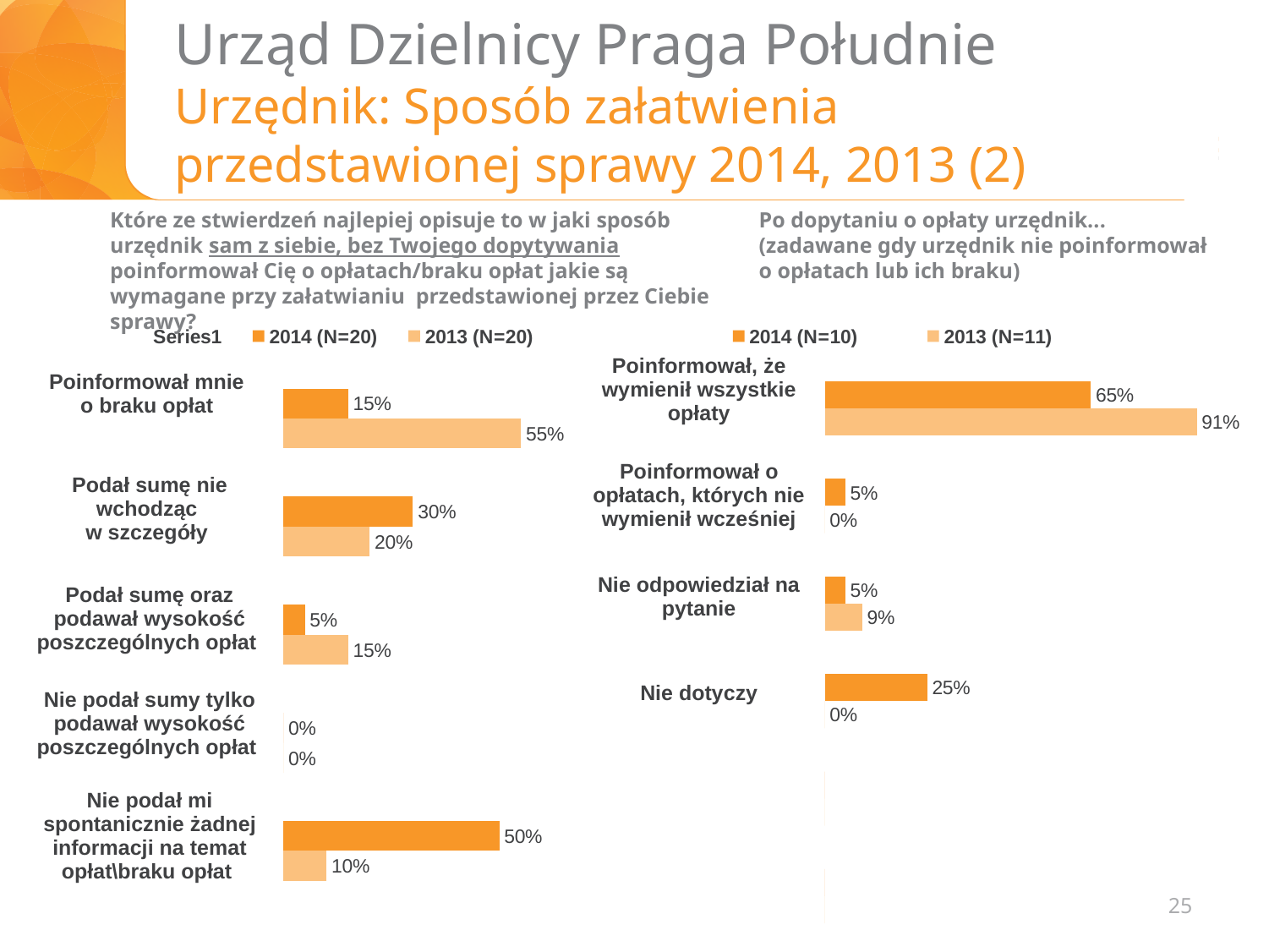
How many series does the legend of the right chart list? 2 In the right chart, what is the 2014 (N=10) value for 'Nie dotyczy'? 25% In the left chart, what is the 2013 (N=20) value for 'Poinformował mnie o braku opłat'? 55% In the left chart, what is the 2014 (N=20) value for 'Nie podał mi spontanicznie żadnej informacji na temat opłat\braku opłat'? 50% What type of chart is the left chart? Bar chart In the right chart, what is the difference between the 2013 (N=11) and 2014 (N=10) values for 'Poinformował, że wymienił wszystkie opłaty'? 26 percentage points In the left chart, which category has the highest 2014 (N=20) value? Nie podał mi spontanicznie żadnej informacji na temat opłat\braku opłat In the left chart, for 'Podał sumę nie wchodząc w szczegóły', which year has the larger value, 2014 or 2013? 2014 In the left chart, which category has the highest 2013 (N=20) value? Poinformował mnie o braku opłat How many categories does the right chart show? 4 In the right chart, what is the 2013 (N=11) value for 'Poinformował, że wymienił wszystkie opłaty'? 91% In the left chart, what is the difference between the 2013 (N=20) and 2014 (N=20) values for 'Poinformował mnie o braku opłat'? 40 percentage points